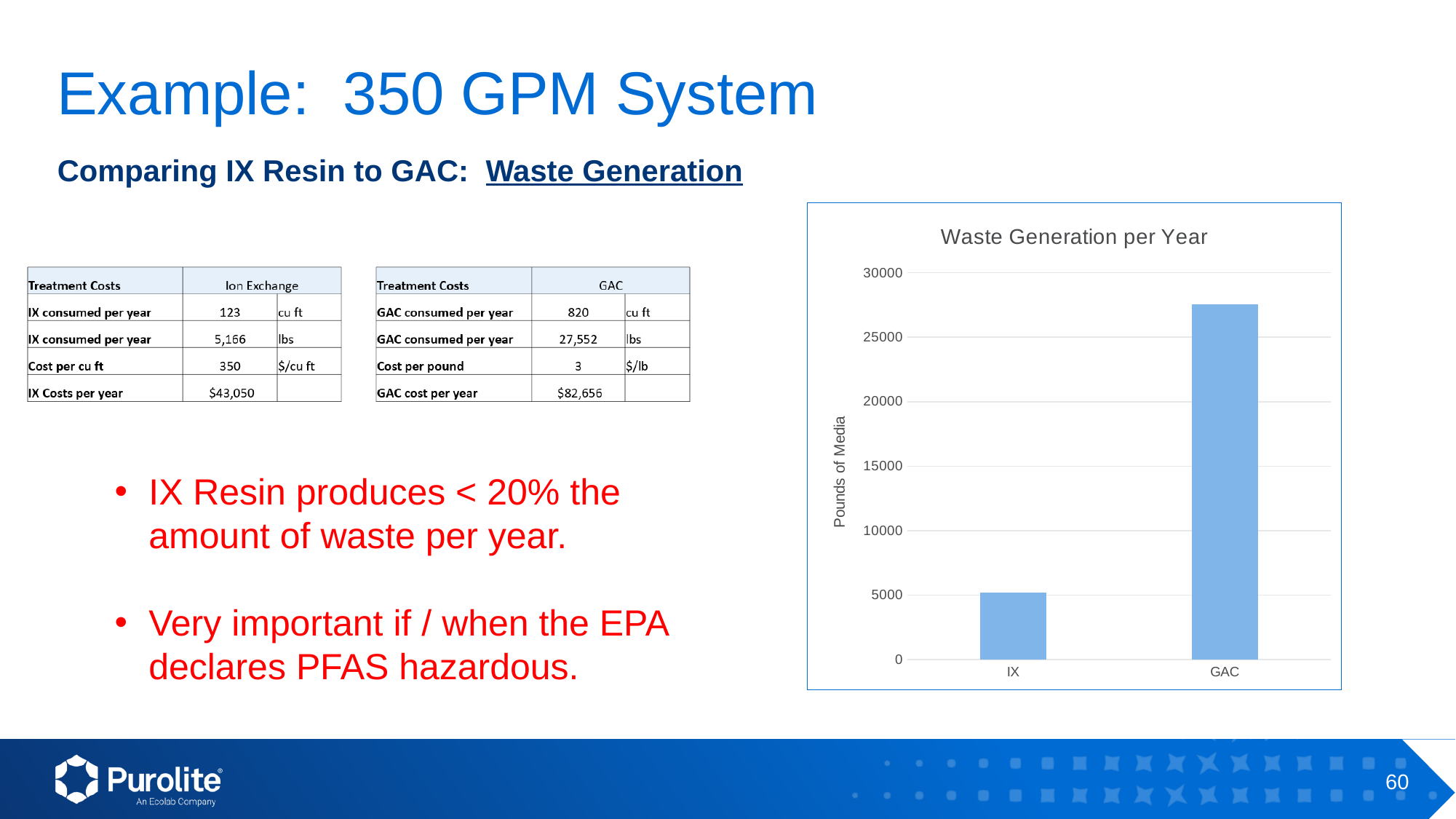
Is the value for GAC greater or less than 25000? greater What is the title of the chart? Waste Generation per Year How many categories are plotted in the chart? 2 What kind of chart is shown on the slide? bar chart Is the value for IX greater or less than 15000? less Do the values rise or fall moving from IX to GAC along the x axis? rise Which is larger in the chart, the value for IX or the value for GAC? GAC Which category has the highest value in the chart? GAC Is the value for GAC greater or less than 30000? less Which category has the lowest value in the chart? IX What is the label on the vertical axis of the chart? Pounds of Media